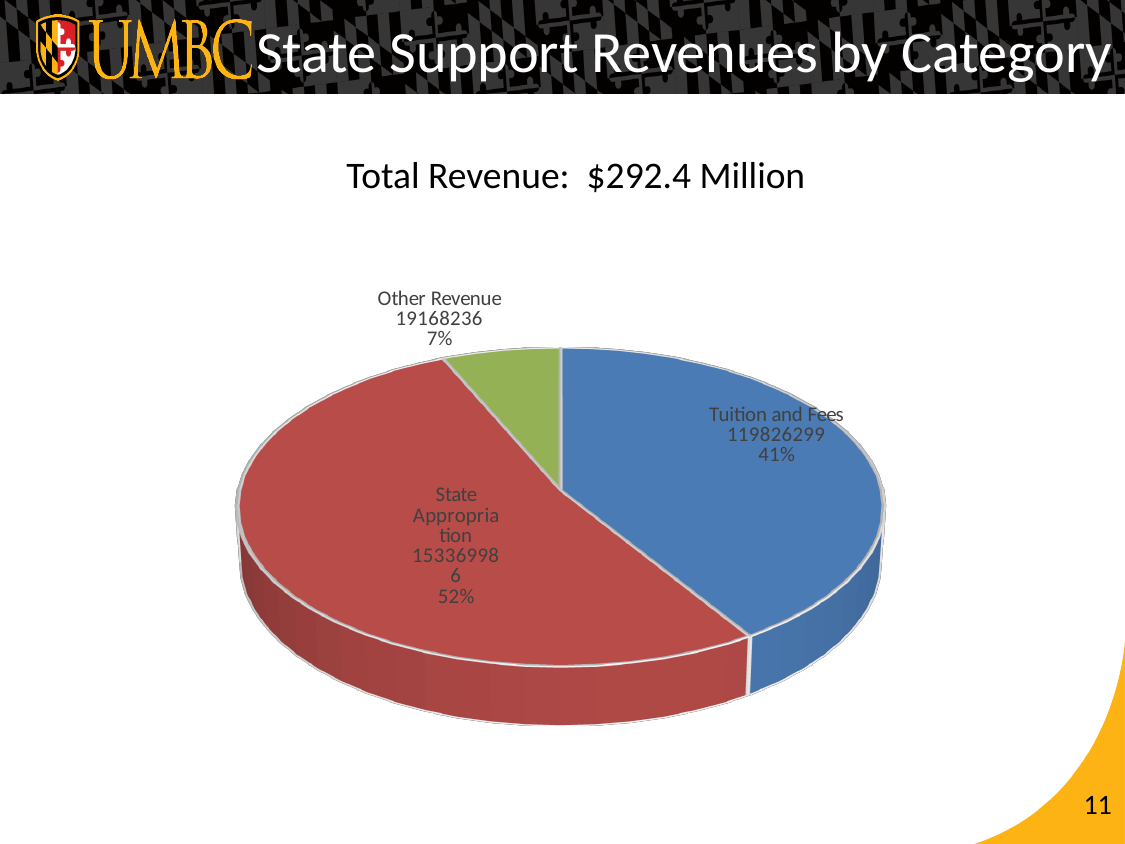
Which category has the smallest slice of the pie? Other Revenue What kind of chart is shown on the slide? pie chart What is the value for Tuition and Fees? 119826299 What share of the pie does Other Revenue represent? 7% What share of the pie does Tuition and Fees represent? 41% What is the value for Other Revenue? 19168236 How many categories does the pie chart show? 3 Which is larger, Tuition and Fees or State Appropriation? State Appropriation What is the value for State Appropriation? 153369986 What total revenue does the slide state above the chart? $292.4 Million Which category has the largest slice of the pie? State Appropriation What share of the pie does State Appropriation represent? 52%